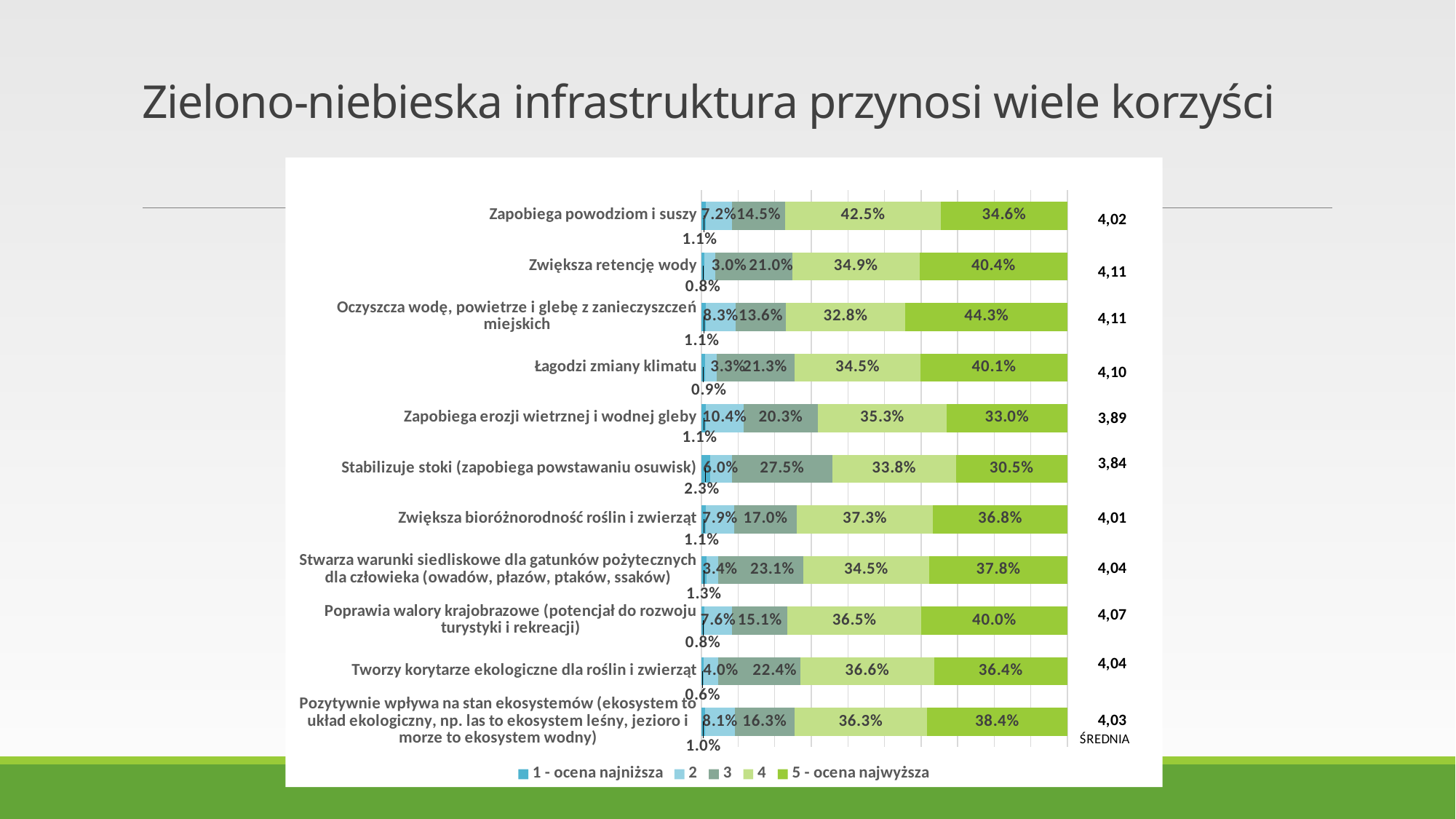
Which category has the highest value for series '3'? Stabilizuje stoki (zapobiega powstawaniu osuwisk) Which category has the highest value for '5 - ocena najwyższa'? Oczyszcza wodę, powietrze i glebę z zanieczyszczeń miejskich What is the value of series '4' for 'Zapobiega powodziom i suszy'? 42.5% What is the difference between the highest and lowest '5 - ocena najwyższa' values (44.3% and 30.5%)? 13.8 percentage points Which has a larger value for series '3': 'Stabilizuje stoki (zapobiega powstawaniu osuwisk)' or 'Zapobiega powodziom i suszy'? Stabilizuje stoki (zapobiega powstawaniu osuwisk) What is the value of '5 - ocena najwyższa' for 'Oczyszcza wodę, powietrze i glebę z zanieczyszczeń miejskich'? 44.3% What kind of chart is shown on the slide? Stacked bar chart What is the value of '1 - ocena najniższa' for 'Stabilizuje stoki (zapobiega powstawaniu osuwisk)'? 2.3% How many series does the legend list? 5 Which category has the lowest value for '5 - ocena najwyższa'? Stabilizuje stoki (zapobiega powstawaniu osuwisk) What is the ŚREDNIA (average) shown for 'Zapobiega erozji wietrznej i wodnej gleby'? 3,89 How many categories (benefits) are plotted in the chart? 11